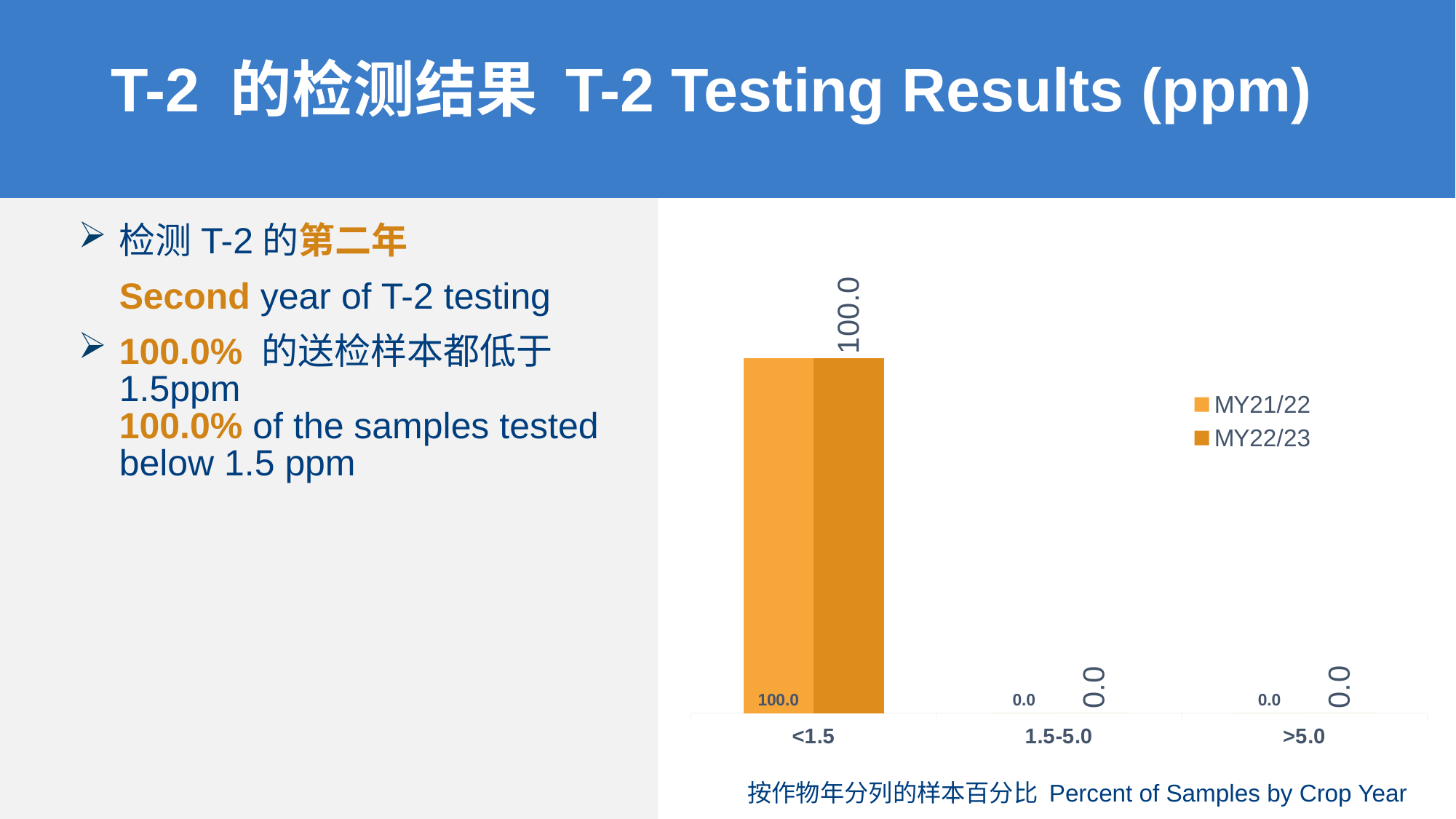
What is the value for MY21/22 in the 1.5-5.0 category? 0.0 What is the value for MY22/23 in the <1.5 category? 100.0 What is the English part of the chart's axis caption below the categories? Percent of Samples by Crop Year Which is larger for MY21/22: the value for <1.5 or the value for 1.5-5.0? <1.5 How many categories are shown on the x axis of the chart? 3 Which category has the highest value for MY22/23? <1.5 What is the value for MY21/22 in the <1.5 category? 100.0 How many series does the chart legend list? 2 What are the two series named in the chart legend? MY21/22 and MY22/23 What is the value for MY22/23 in the >5.0 category? 0.0 What kind of chart is shown on the slide? bar chart What is the difference between the MY22/23 values for <1.5 and >5.0? 100.0